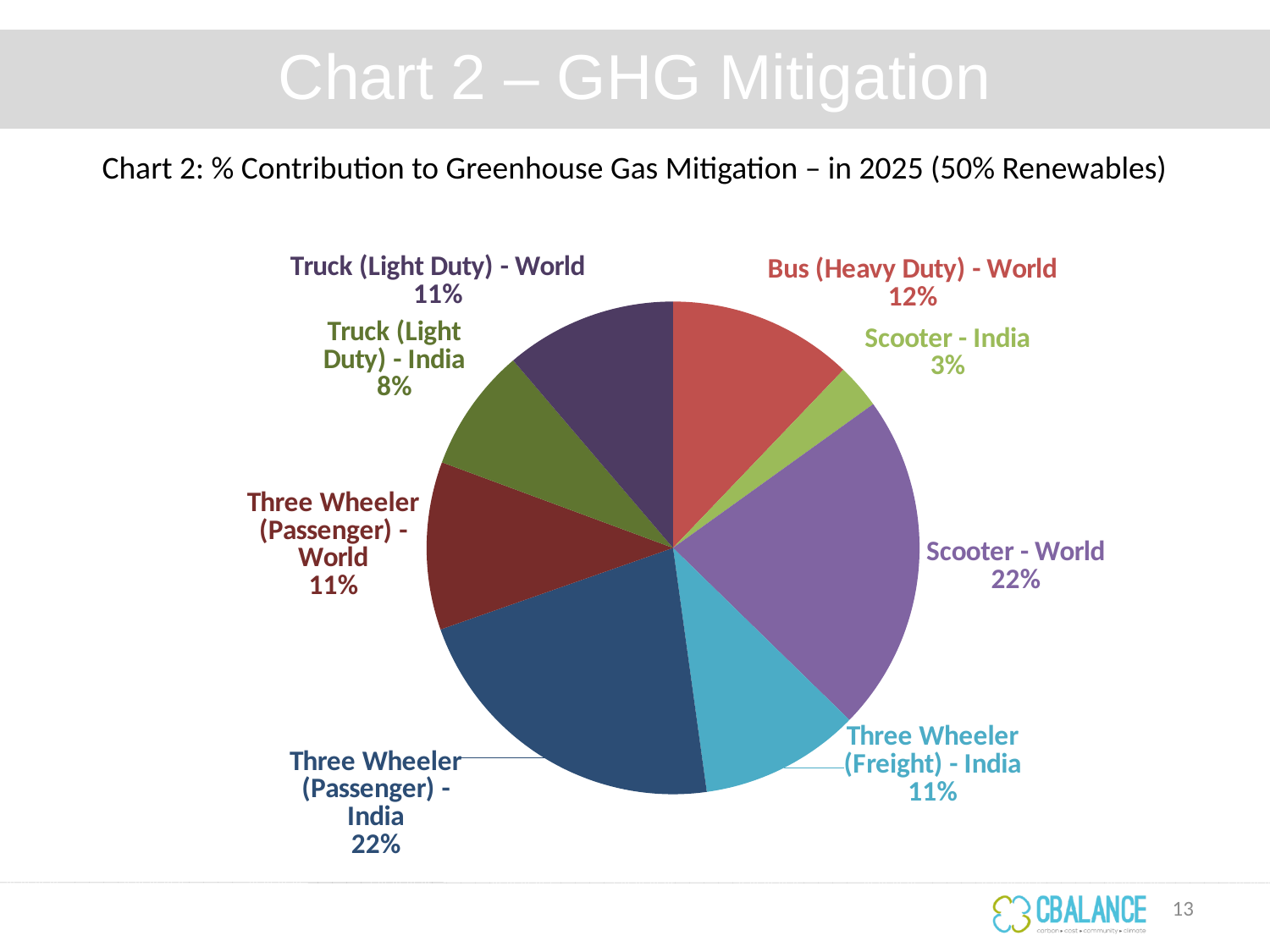
What is the title of the chart shown on the slide? Chart 2: % Contribution to Greenhouse Gas Mitigation – in 2025 (50% Renewables) What is the share for Truck (Light Duty) - World? 11% Which has a larger share: Bus (Heavy Duty) - World or Truck (Light Duty) - India? Bus (Heavy Duty) - World What is the combined share of Three Wheeler (Passenger) - India and Three Wheeler (Passenger) - World? 33% What is the share for Scooter - World? 22% How many categories (slices) does the pie chart have? 8 What is the share for Truck (Light Duty) - India? 8% What is the share for Bus (Heavy Duty) - World? 12% What type of chart is shown on the slide? Pie chart Which category has the smallest share of the pie? Scooter - India What is the share for Three Wheeler (Freight) - India? 11% What is the difference between the shares of Scooter - World and Scooter - India? 19%